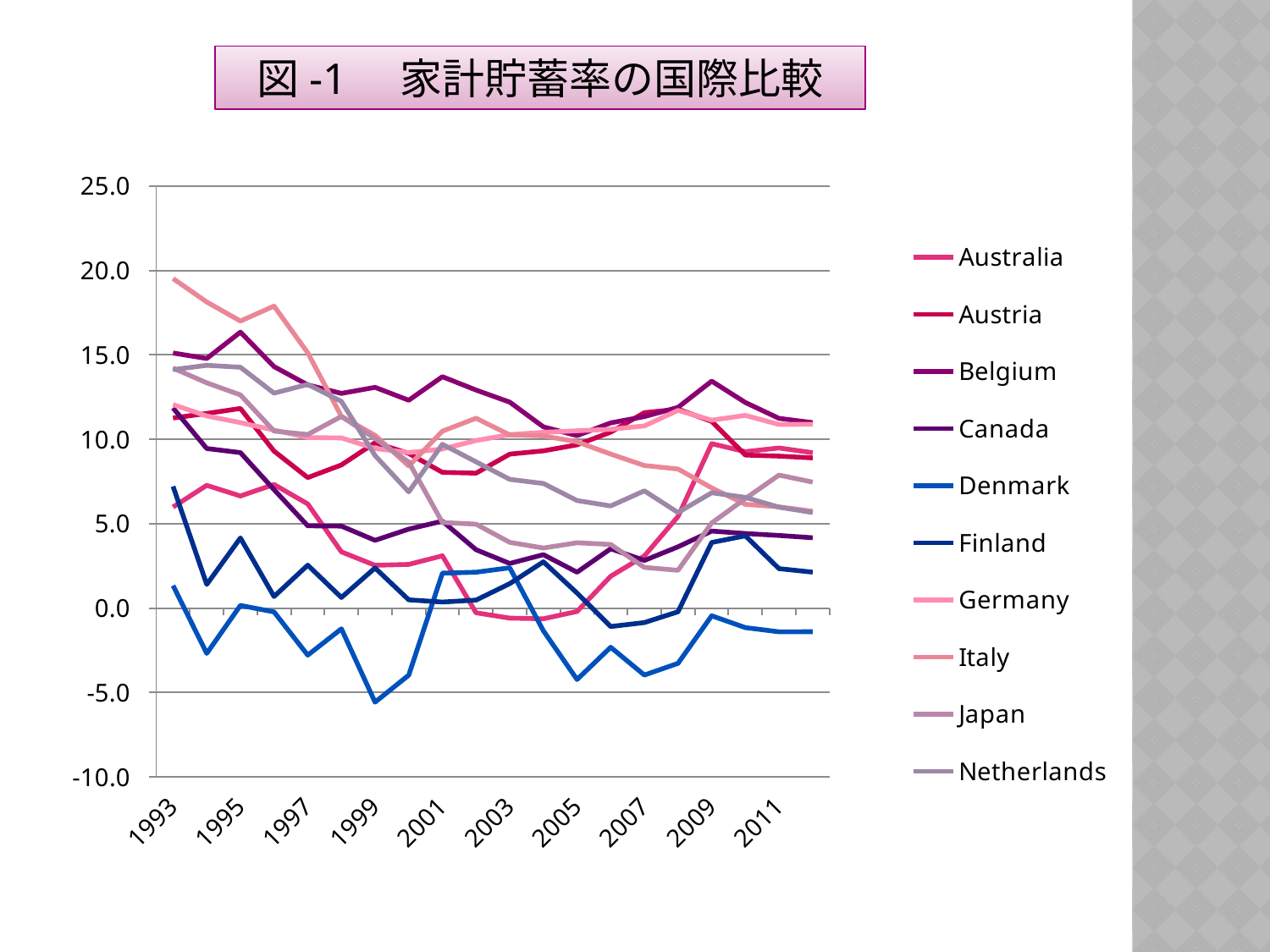
Is the value for Italy in 1993 greater or less than 15.0? greater What is the highest value shown on the vertical axis? 25.0 In 1993, which is larger, the value for Italy or the value for Denmark? Italy Which series reaches the lowest value anywhere on the chart? Denmark What is the title of the chart? 図-1 家計貯蓄率の国際比較 How many series does the legend list? 10 Is the value for Denmark in 1993 greater or less than 5.0? less Which series has the highest value in 1993? Italy Is the value for Japan in 1993 greater or less than 10.0? greater What kind of chart is shown on the slide? line chart Does the value for Italy rise or fall overall from 1993 to 2011? fall